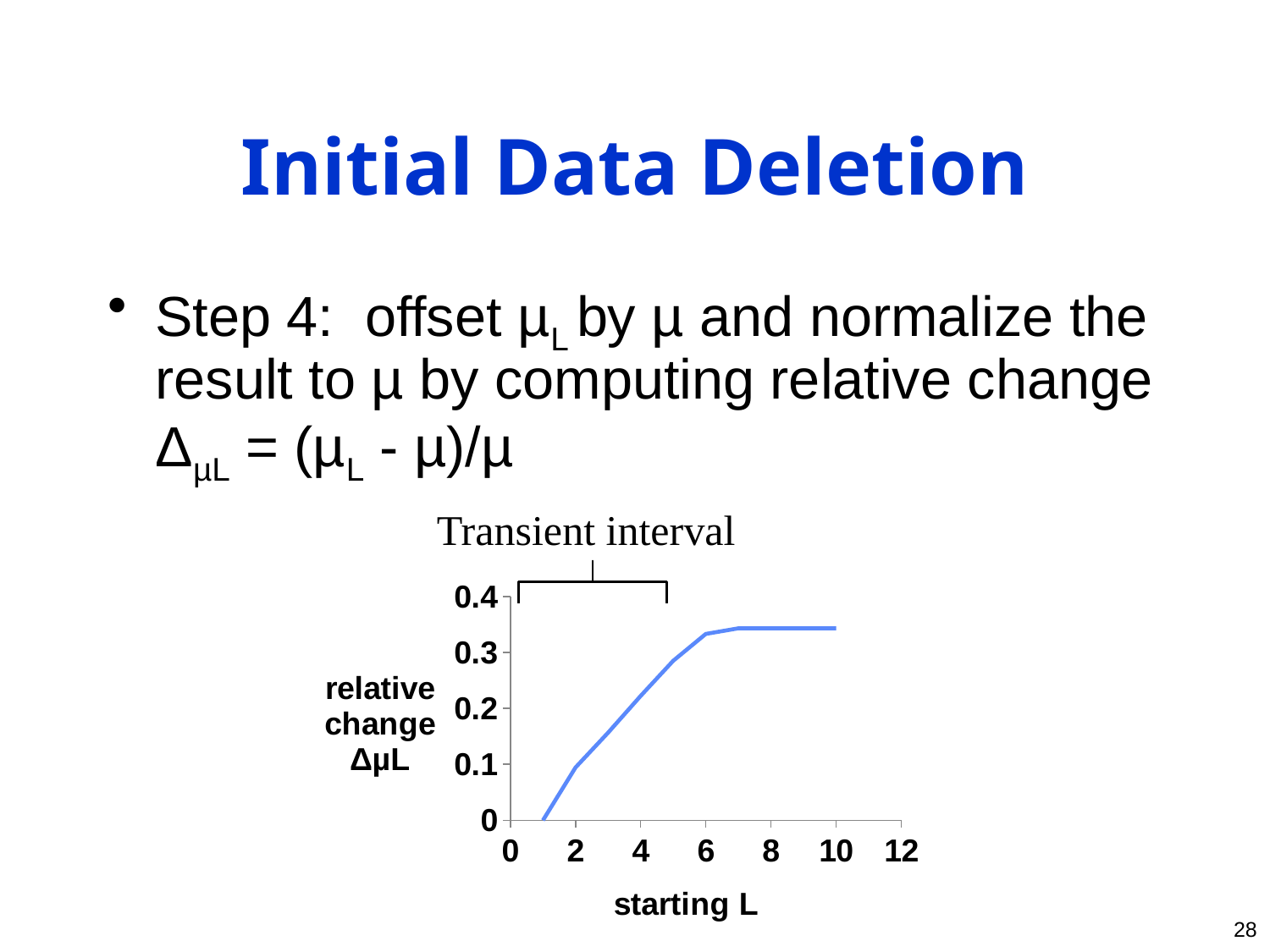
Is the value of relative change ΔμL at starting L = 3 greater or less than 0.1? greater Is the value of relative change ΔμL at starting L = 6 greater or less than 0.3? greater How does relative change ΔμL behave as starting L increases from 1 to 6? it rises Is the value of relative change ΔμL at starting L = 8 greater or less than 0.3? greater What is the label of the x axis of the chart? starting L How does relative change ΔμL behave as starting L increases from 7 to 10? it stays roughly flat What kind of chart is shown on the slide? line chart What is the label of the y axis of the chart? relative change ΔμL Which has the larger relative change ΔμL: starting L = 2 or starting L = 6? starting L = 6 Which has the larger relative change ΔμL: starting L = 4 or starting L = 8? starting L = 8